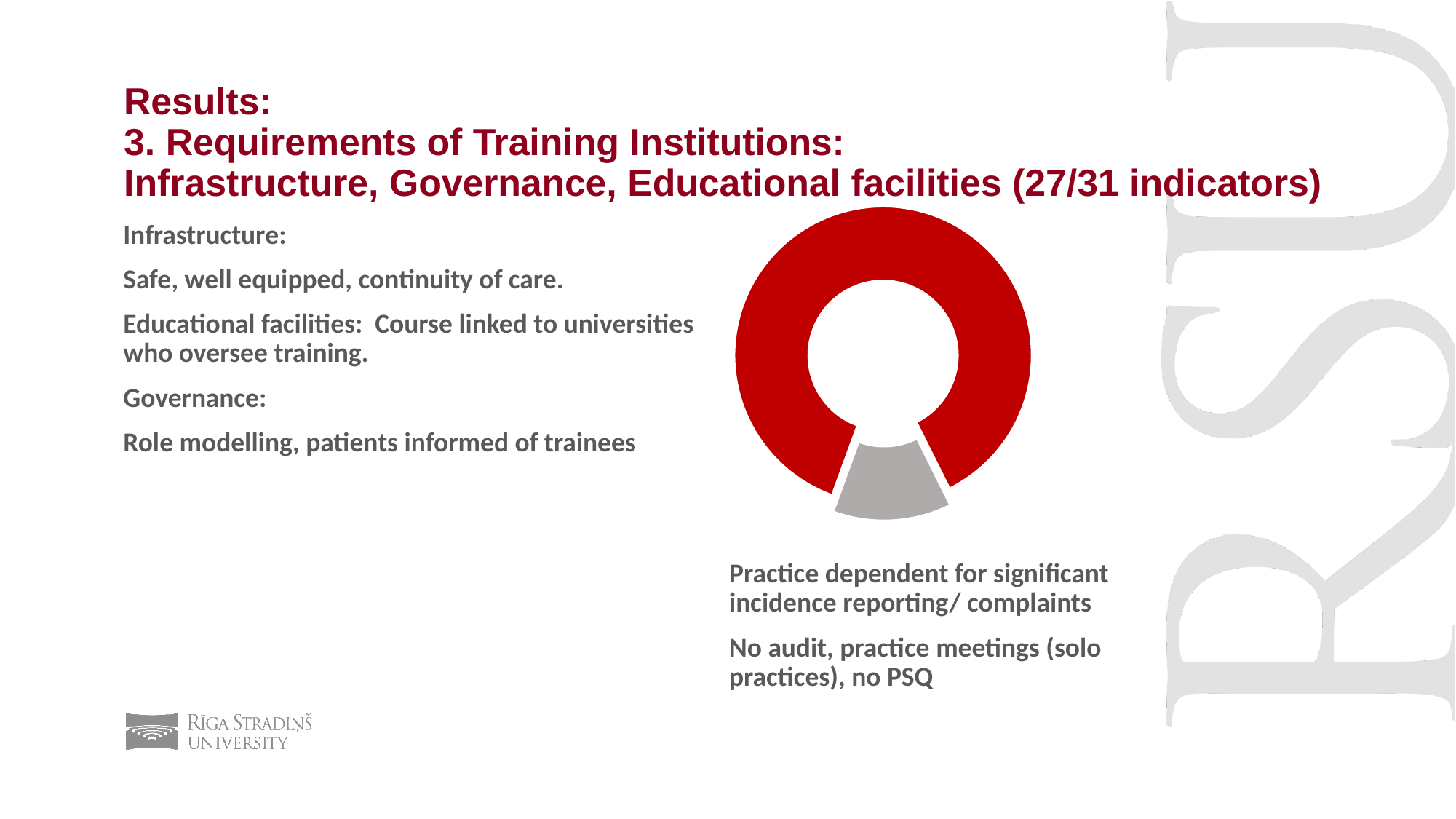
How many slices does the doughnut chart have? 2 Which slice of the doughnut chart is the largest? the red slice Which slice of the doughnut chart is larger, the red one or the grey one? the red one Which slice of the doughnut chart is the smallest? the grey slice What kind of chart is shown on the slide? doughnut chart Does the doughnut chart display a legend? No What colour is the larger slice of the doughnut chart? red